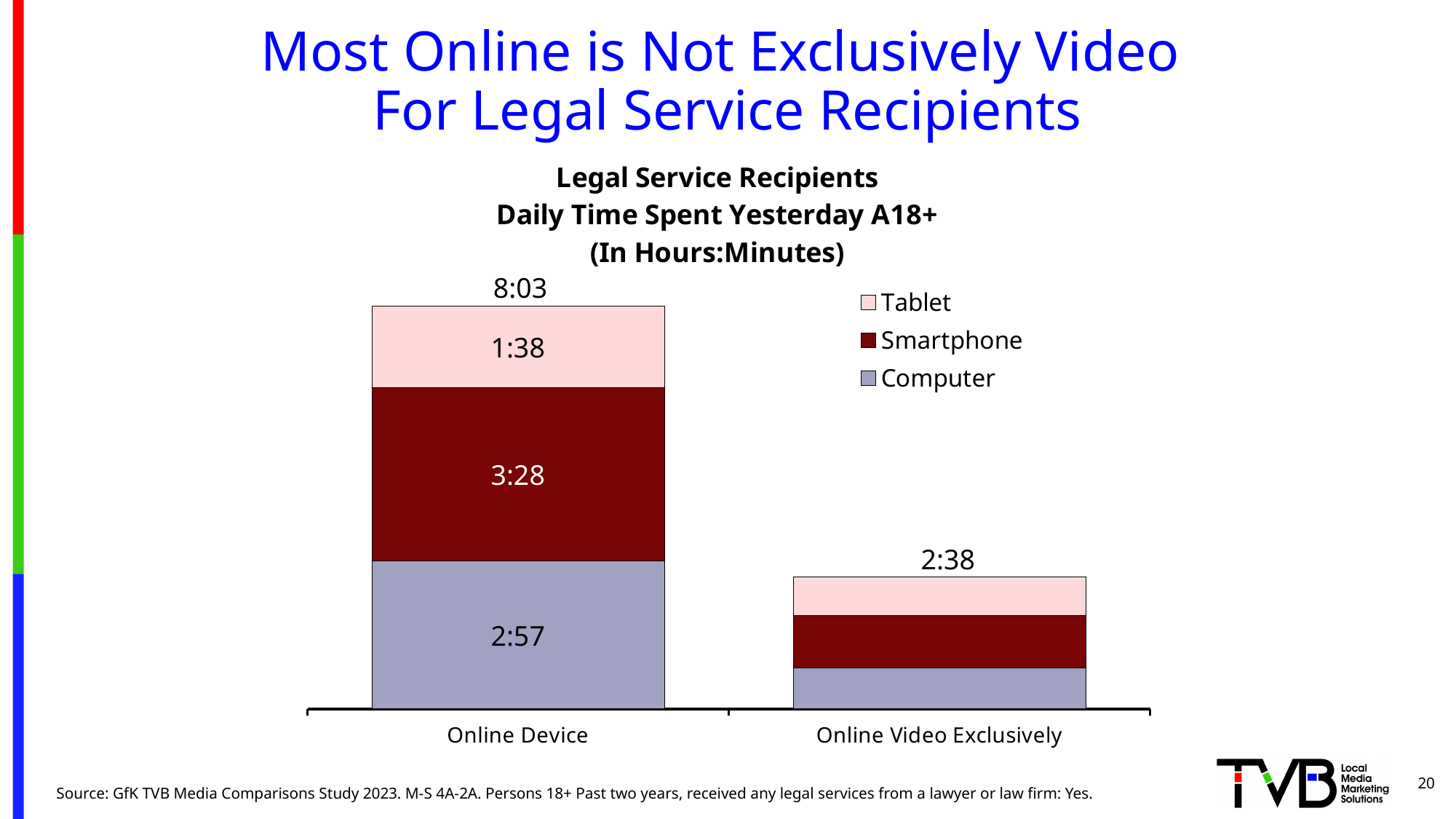
What kind of chart is shown on the slide? Stacked bar chart What is the difference between the Online Device total and the Online Video Exclusively total? 5:25 What is the total daily time spent for Online Video Exclusively? 2:38 Within the Online Device bar, which device accounts for the least time? Tablet What is the Computer value for Online Device? 2:57 What is the total daily time spent for Online Device? 8:03 What is the Tablet value for Online Device? 1:38 What is the Smartphone value for Online Device? 3:28 How many series does the legend list? 3 Which category has the higher total, Online Device or Online Video Exclusively? Online Device Within the Online Device bar, which device accounts for the most time? Smartphone Which series is shown in dark red? Smartphone